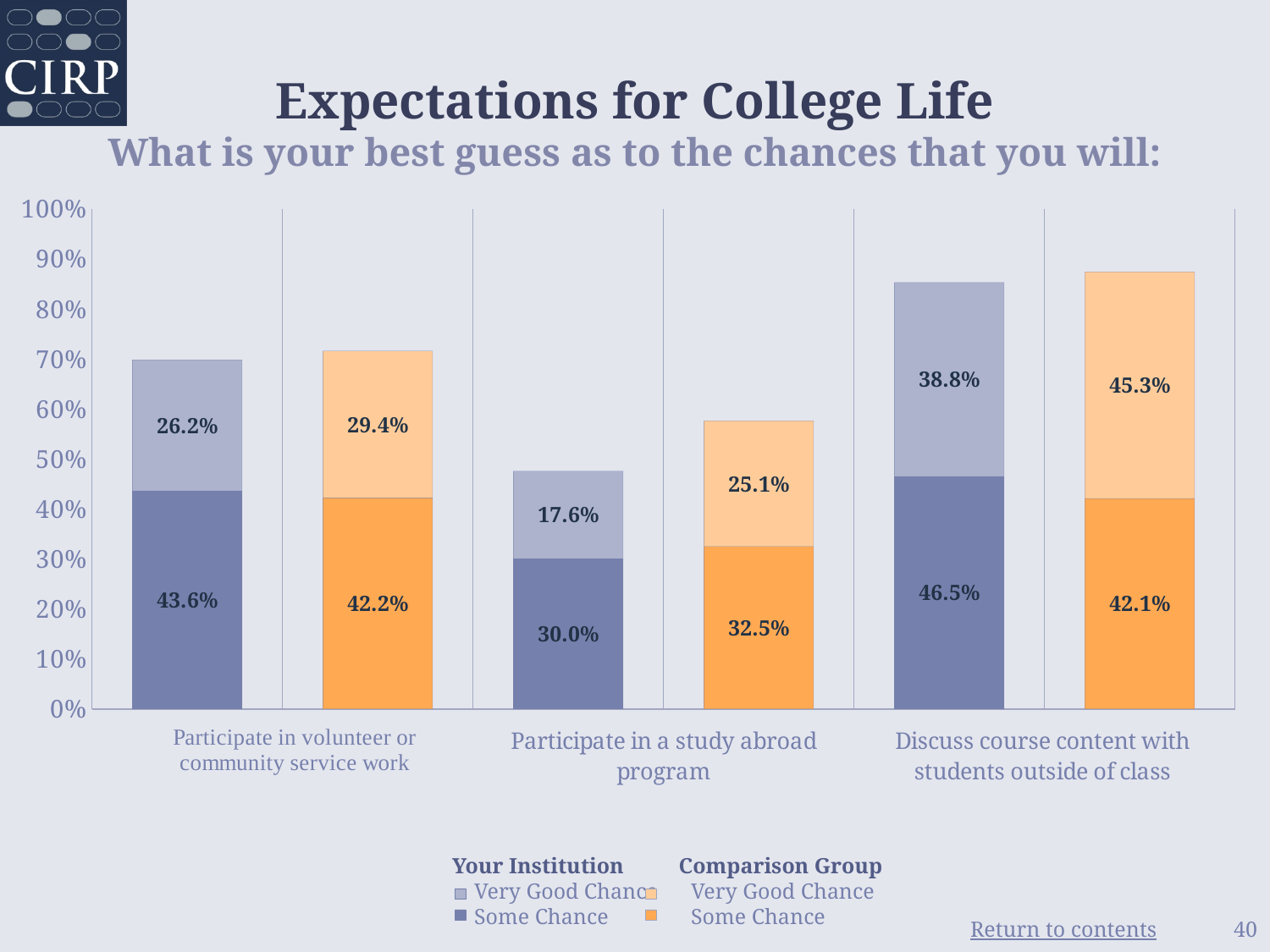
Which category has the highest Your Institution 'Very Good Chance' value? Discuss course content with students outside of class Which category has the lowest Comparison Group 'Some Chance' value? Participate in a study abroad program What is the Comparison Group 'Very Good Chance' value for 'Discuss course content with students outside of class'? 45.3% What is the Your Institution 'Some Chance' value for 'Participate in volunteer or community service work'? 43.6% How many categories are shown on the x axis? 3 What is the total height of the Your Institution stacked bar for 'Participate in volunteer or community service work'? 69.8% What kind of chart is shown on the slide? stacked bar chart How many entries does the legend list? 4 What is the total height of the Comparison Group stacked bar for 'Discuss course content with students outside of class'? 87.4% Which is larger for 'Participate in a study abroad program': the Your Institution 'Some Chance' value or the Comparison Group 'Some Chance' value? Comparison Group 'Some Chance' (32.5%) What is the difference between the Comparison Group and Your Institution 'Very Good Chance' values for 'Discuss course content with students outside of class'? 6.5% What is the Your Institution 'Very Good Chance' value for 'Participate in a study abroad program'? 17.6%